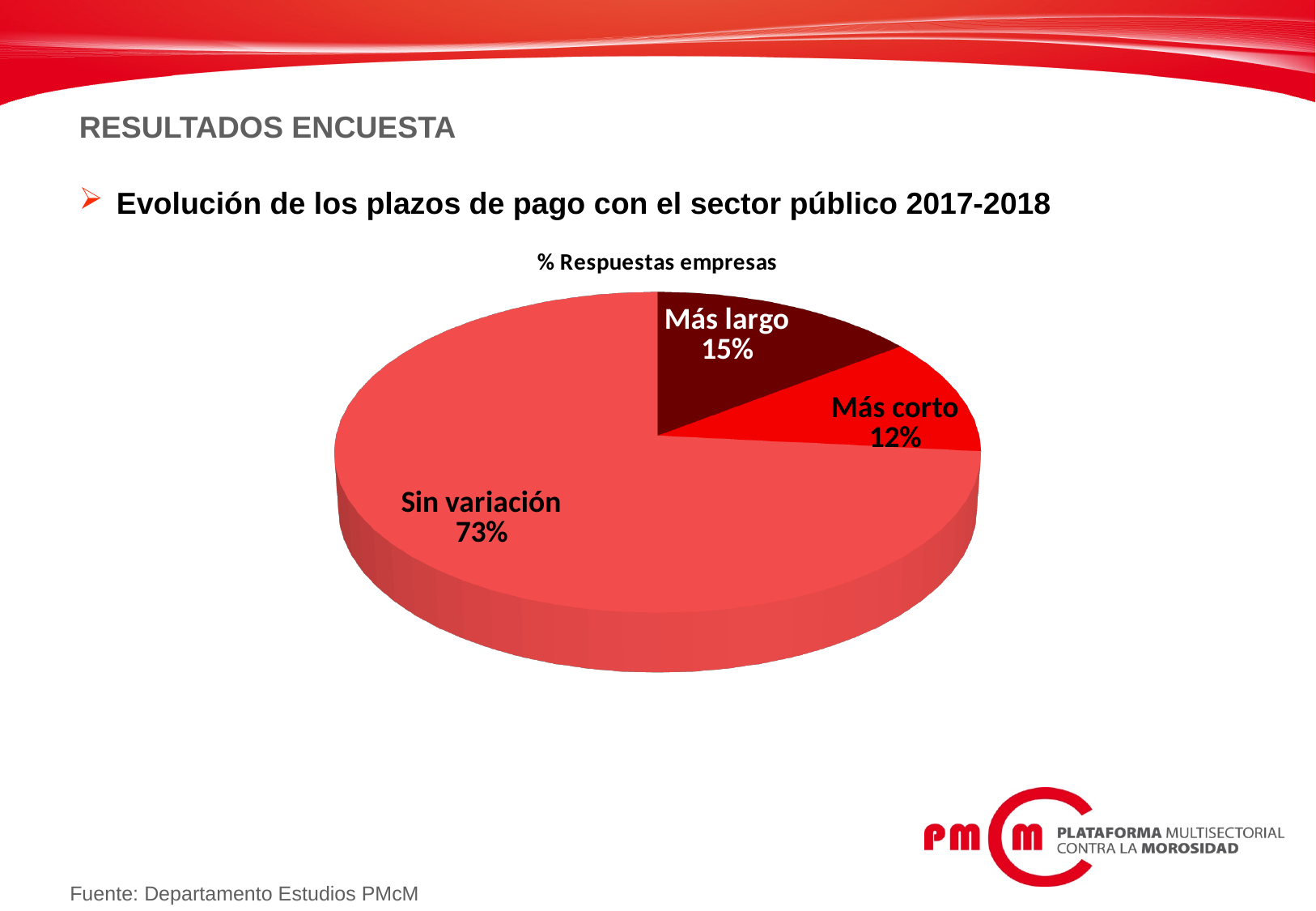
What is the combined share of 'Más largo' and 'Más corto'? 27% Which category has the smallest share of the pie? Más corto What is the difference in percentage points between 'Más largo' and 'Más corto'? 3 How many slices does the pie chart have? 3 What percentage of responses is labelled 'Más corto'? 12% What percentage of responses is labelled 'Más largo'? 15% What is the difference in percentage points between 'Sin variación' and 'Más largo'? 58 What is the title of the chart? % Respuestas empresas Which category has the largest share of the pie? Sin variación What type of chart is shown on the slide? Pie chart What percentage of responses is labelled 'Sin variación'? 73% Which is larger, the share for 'Más largo' or the share for 'Más corto'? Más largo